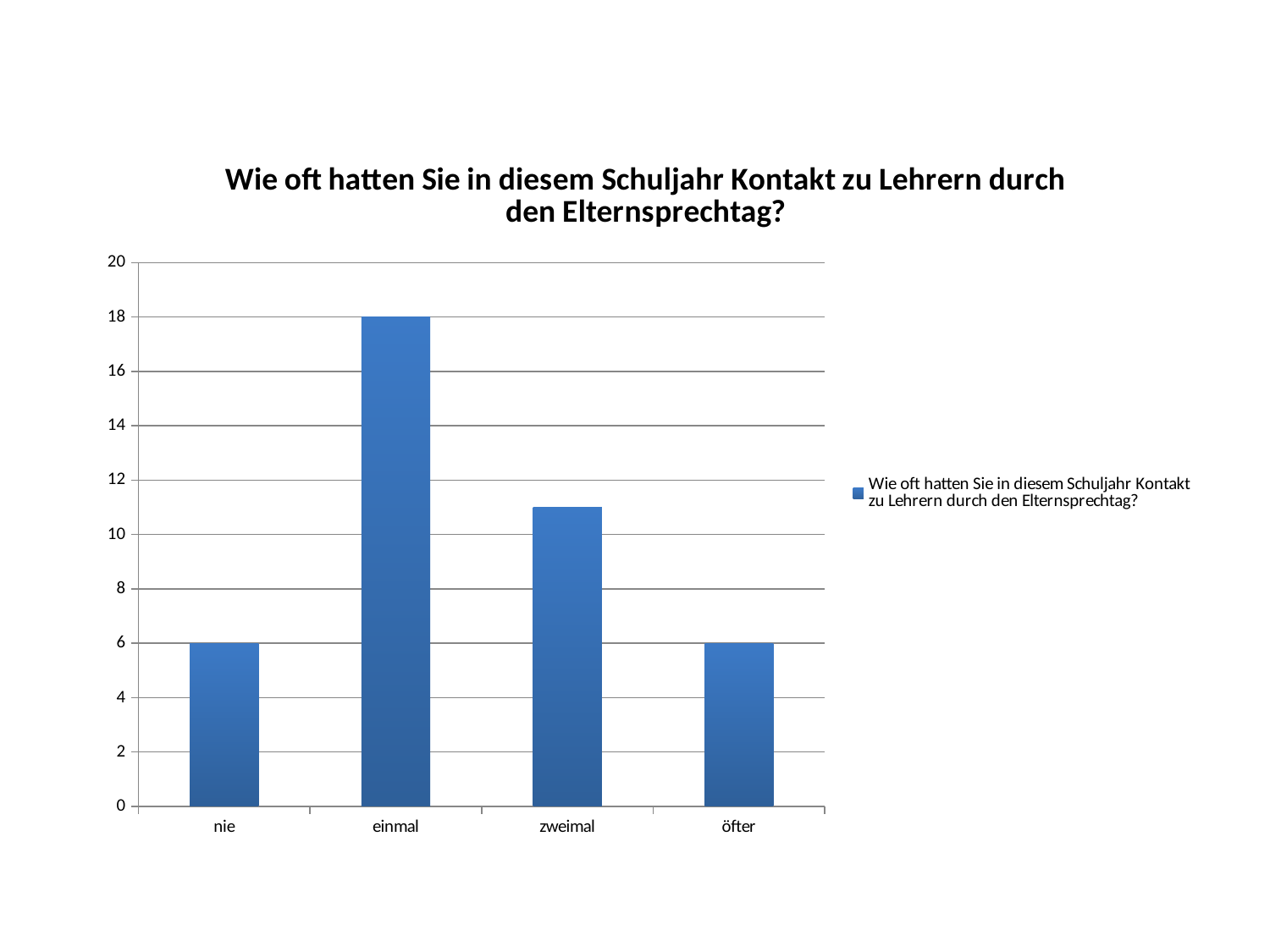
How many categories are shown on the x axis? 4 Which is larger, the value for "einmal" or the value for "zweimal"? einmal What is the title of the chart? Wie oft hatten Sie in diesem Schuljahr Kontakt zu Lehrern durch den Elternsprechtag? What is the value for "einmal"? 18 Is the value for "zweimal" greater or less than 12? less What is the difference between the values for "einmal" and "nie"? 12 How many series does the legend list? 1 What is the value for "nie"? 6 What is the value for "öfter"? 6 Is the value for "zweimal" greater or less than 10? greater Which category has the highest value? einmal What kind of chart is shown on the slide? bar chart